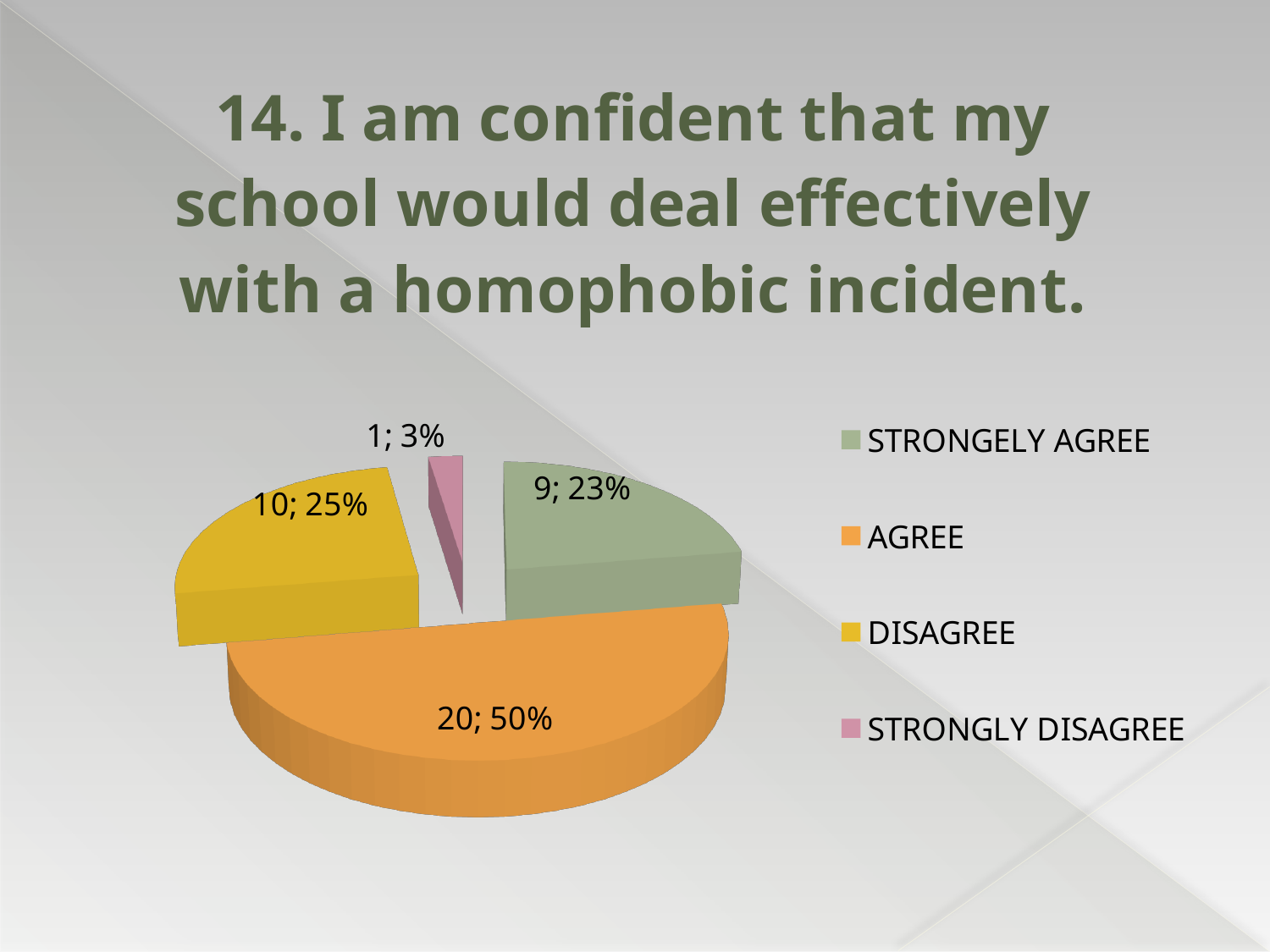
Which response category has the largest slice? AGREE How many respondents chose AGREE? 20 Which colour represents DISAGREE in the legend? yellow How many more respondents chose AGREE than DISAGREE? 10 Which has more respondents, STRONGLY AGREE or DISAGREE? DISAGREE What percentage of respondents chose STRONGLY AGREE? 23% What is the total number of respondents across all slices? 40 What kind of chart is shown on the slide? pie chart Which response category has the smallest slice? STRONGLY DISAGREE What share of the pie does STRONGLY DISAGREE represent? 3% How many categories does the pie chart have? 4 How many respondents chose DISAGREE? 10